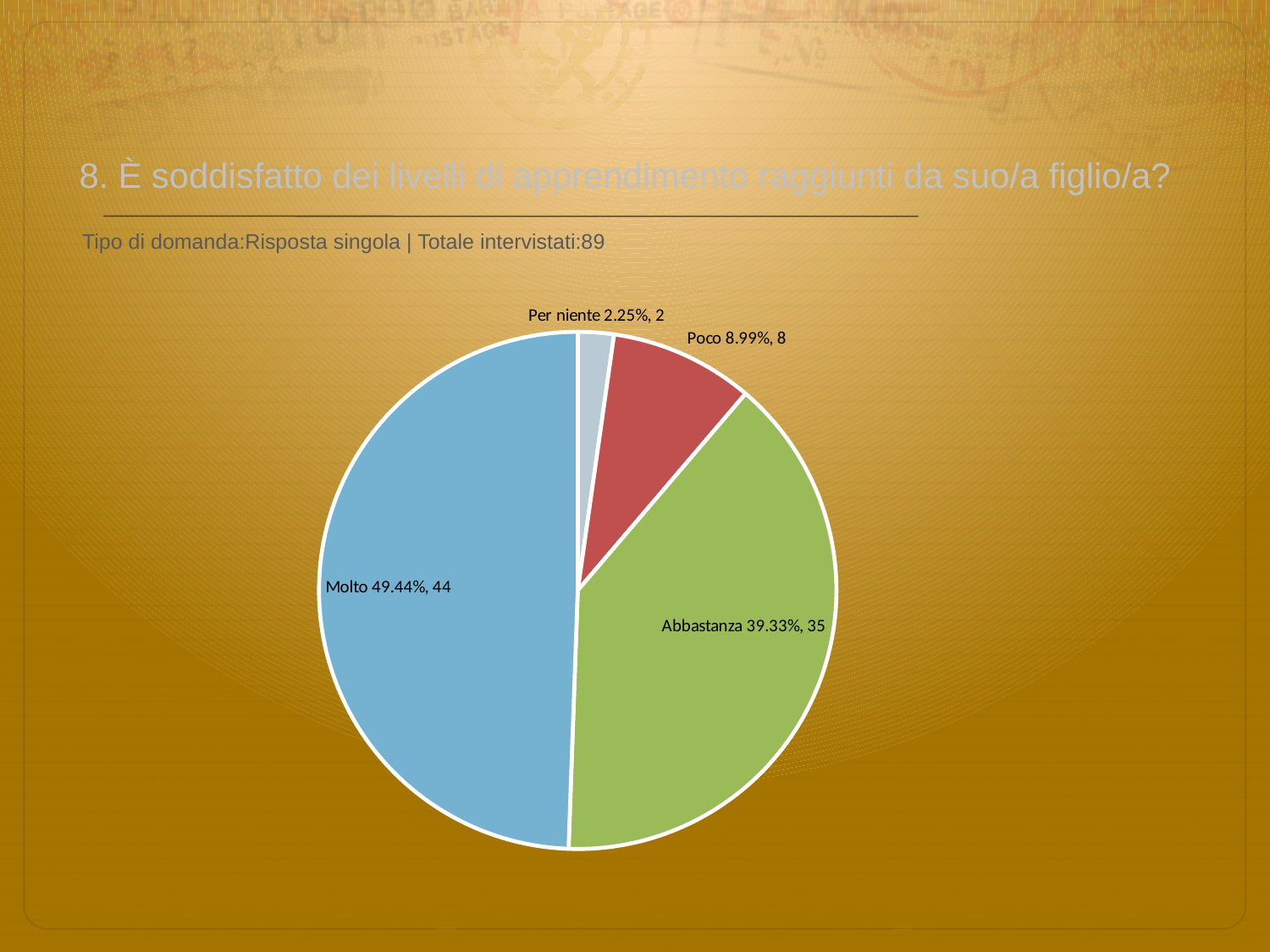
How many respondents answered 'Abbastanza'? 35 What colour is the 'Abbastanza' slice? green What is the difference in respondent count between 'Molto' and 'Abbastanza'? 9 How many respondents answered 'Poco'? 8 Which has more respondents, 'Poco' or 'Per niente'? Poco How many slices does the pie chart have? 4 What percentage share does the 'Molto' slice have? 49.44% What kind of chart is shown on the slide? pie chart What is the total number of respondents across all slices? 89 Which category has the largest slice? Molto Which category has the smallest slice? Per niente What percentage share does the 'Per niente' slice have? 2.25%